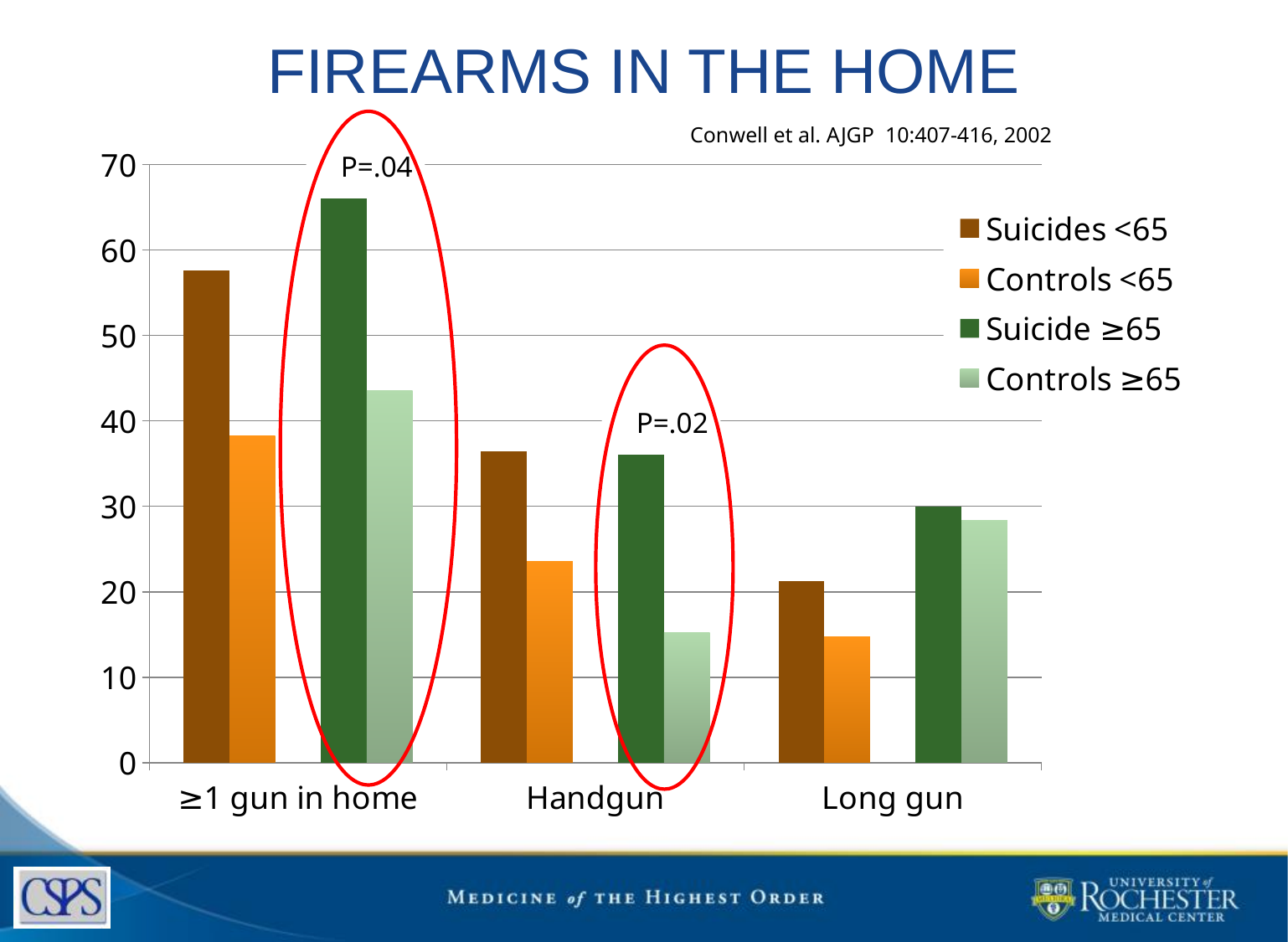
Which series has the lowest bar in the Handgun category? Controls ≥65 Is the value for Suicide ≥65 in the ≥1 gun in home category greater or less than 60? greater Which series has the highest bar in the ≥1 gun in home category? Suicide ≥65 Which series has the lowest bar in the ≥1 gun in home category? Controls <65 In the Long gun category, which is larger: Suicides <65 or Controls <65? Suicides <65 Do the values for Suicides <65 rise or fall from ≥1 gun in home to Long gun? fall What kind of chart is shown on the slide? Bar chart What P value is annotated above the circled bars in the Handgun category? P=.02 How many series does the legend list? 4 Is the value for Controls ≥65 in the Handgun category greater or less than 20? less Is the value for Suicides <65 in the ≥1 gun in home category greater or less than 50? greater How many categories are shown on the x axis? 3